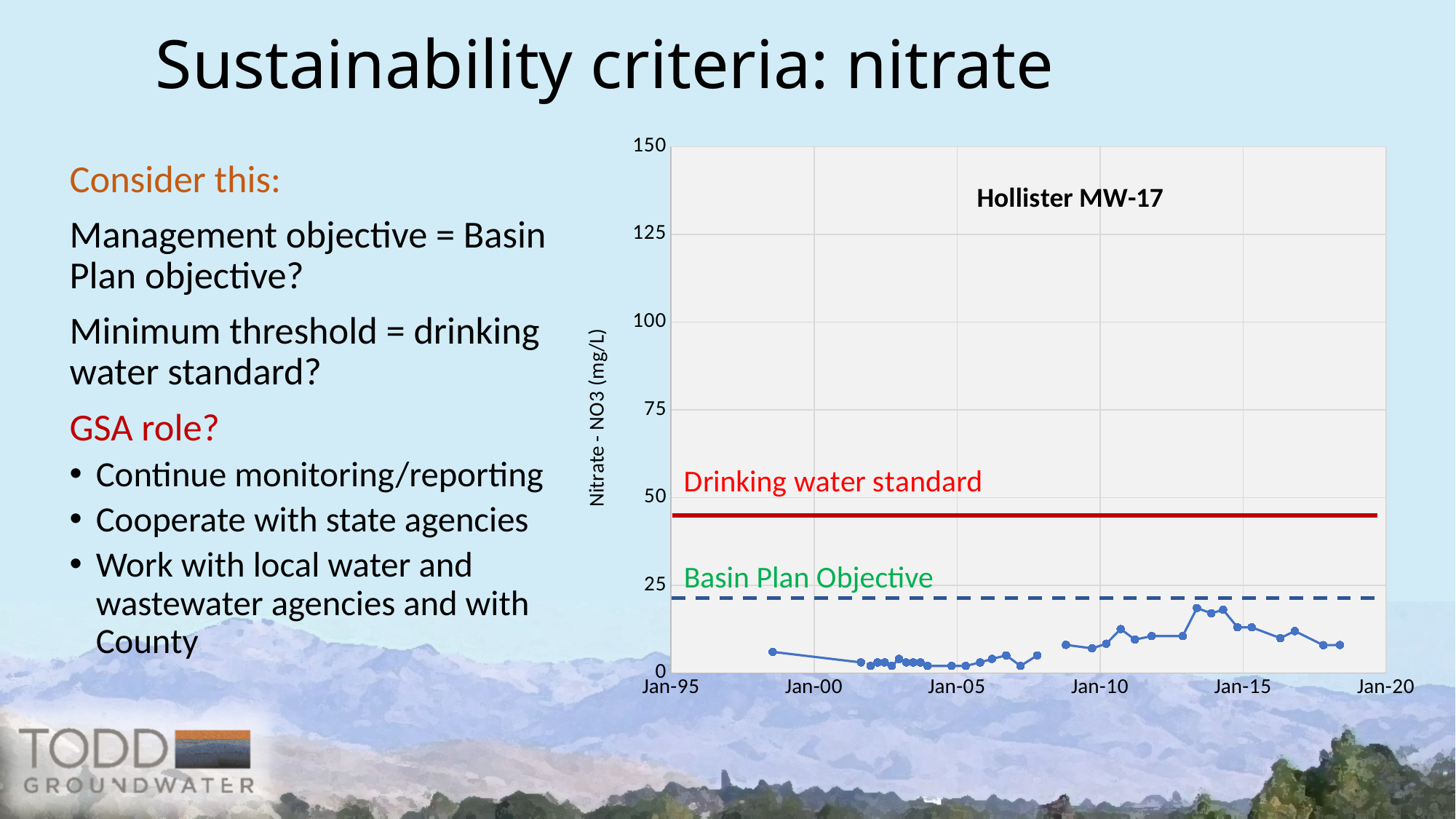
Do any of the plotted nitrate values exceed the Drinking water standard line? No Is the nitrate value near Jan-05 greater or less than 25? less Is the Drinking water standard line greater or less than 50? less Is the highest plotted nitrate value greater or less than 50? less Which is higher, the nitrate value near Jan-14 or the nitrate value near Jan-05? near Jan-14 Which line is higher on the chart, the Drinking water standard or the Basin Plan Objective? Drinking water standard What is the label of the chart's y axis? Nitrate - NO3 (mg/L) Do the plotted nitrate values rise or fall between Jan-10 and Jan-14? rise What is the title of the chart? Hollister MW-17 What kind of chart is shown on the slide? line chart